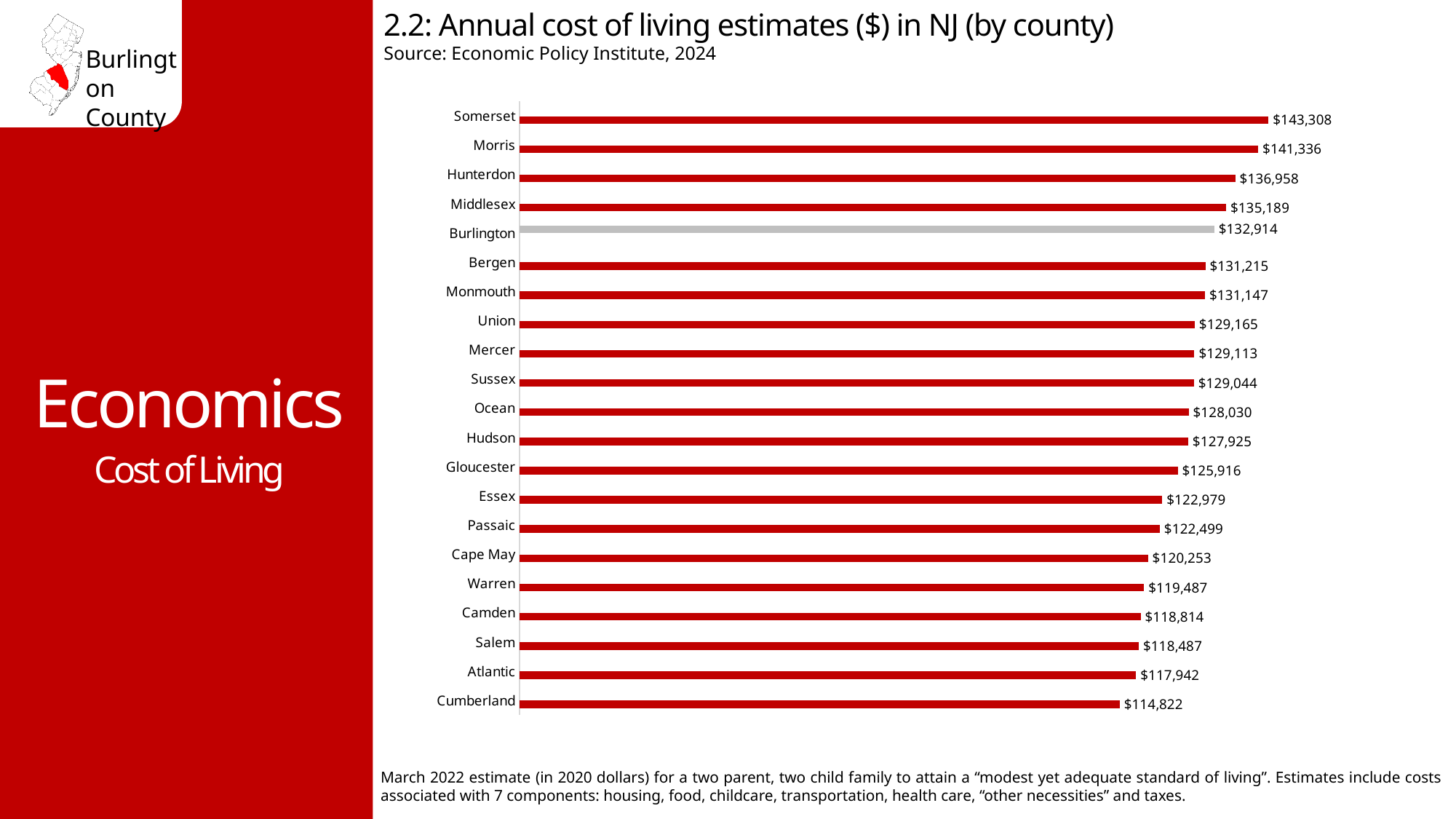
Which county has a higher cost of living estimate, Hunterdon or Middlesex? Hunterdon What is the difference between the cost of living estimates for Burlington and Bergen? $1,699 How many counties are shown in the chart? 21 Which county has the highest annual cost of living estimate? Somerset Which county has a higher cost of living estimate, Essex or Gloucester? Gloucester What is the difference between the cost of living estimates for Somerset and Cumberland? $28,486 What type of chart is used to show the annual cost of living estimates? Bar chart Which county's bar is shown in grey instead of red? Burlington What is the annual cost of living estimate for Burlington County? $132,914 Which county has the lowest annual cost of living estimate? Cumberland What is the annual cost of living estimate for Cape May? $120,253 What is the source cited for the chart? Economic Policy Institute, 2024